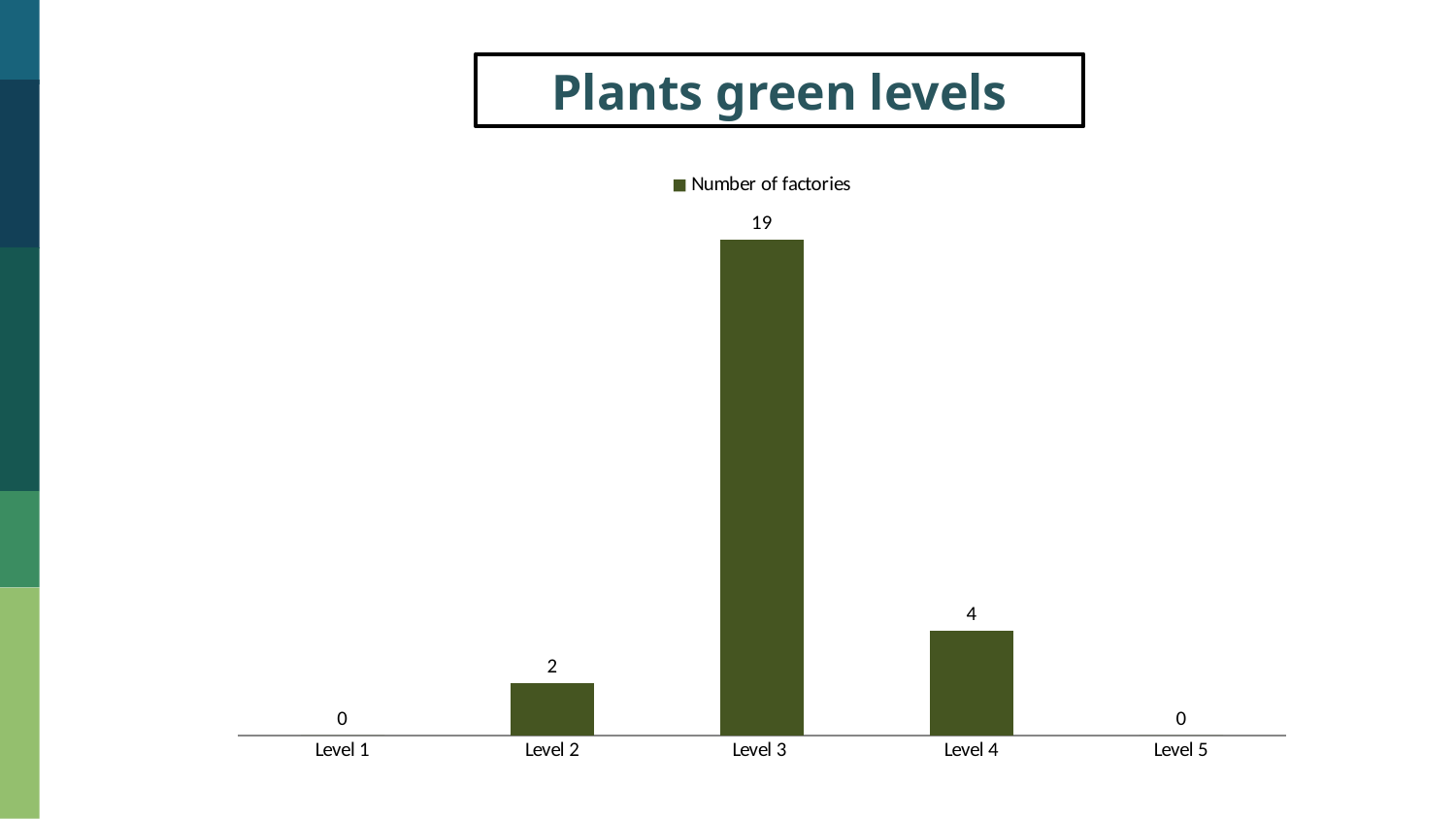
Which has more factories, Level 2 or Level 4? Level 4 Which level has the highest number of factories? Level 3 What kind of chart is shown on the slide? Bar chart How many series does the legend list? 1 What is the difference in the number of factories between Level 4 and Level 2? 2 How many levels are shown on the x axis? 5 What is the title of the slide? Plants green levels What is the number of factories at Level 3? 19 What is the difference in the number of factories between Level 3 and Level 4? 15 What is the number of factories at Level 1? 0 What is the number of factories at Level 4? 4 What is the number of factories at Level 2? 2